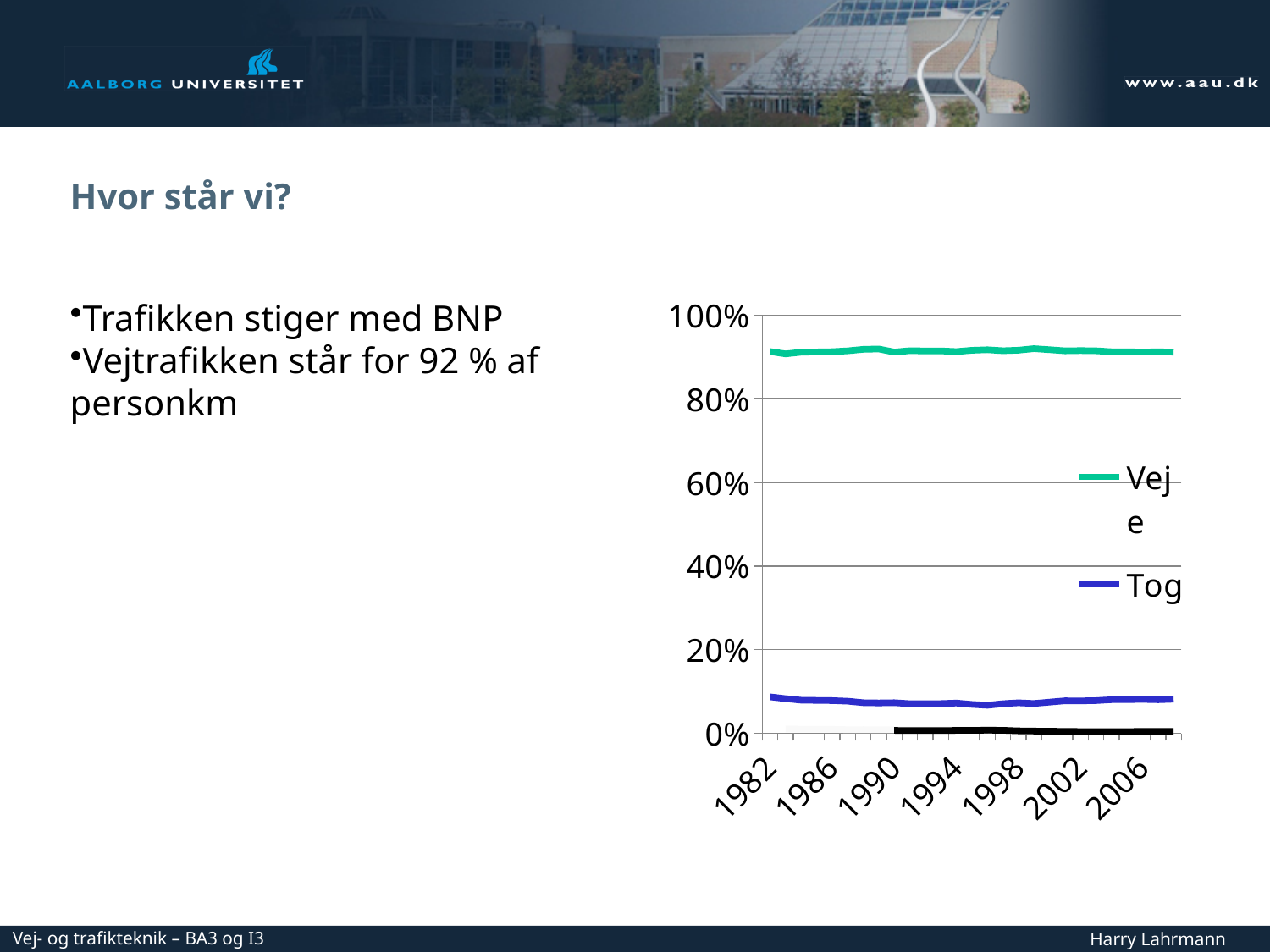
Is the value for Tog in 1990 greater or less than 20%? less What is the first year shown on the x axis of the chart? 1982 How many series does the chart's legend list? 2 How many year labels are shown on the x axis? 7 Does the Veje line rise sharply, fall sharply, or stay roughly flat from 1982 to 2006? stays roughly flat What kind of chart is shown on the slide? line chart Which series has the larger value in 1994, Veje or Tog? Veje What colour is the Veje line in the chart? green Which series in the legend has the highest values across the chart? Veje Is the value for Veje in 1982 greater or less than 80%? greater Is the value for Tog in 2006 greater or less than 20%? less